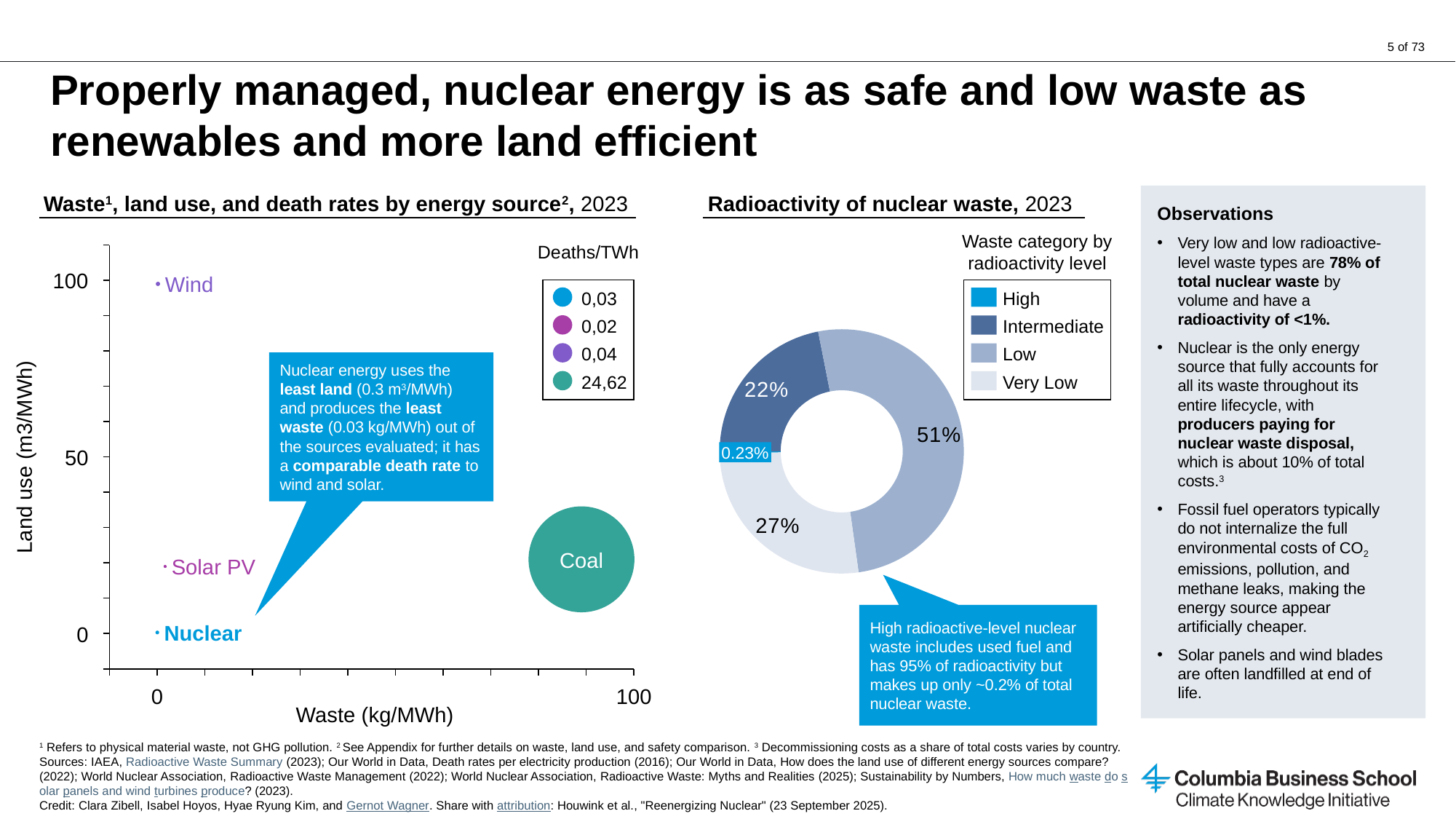
In the 'Waste, land use, and death rates by energy source, 2023' chart, is the waste value for Coal greater or less than 50 kg/MWh? greater In the 'Radioactivity of nuclear waste, 2023' chart, what share of nuclear waste is in the Low radioactivity category? 51% In the 'Radioactivity of nuclear waste, 2023' chart, what is the difference in percentage points between the Low and Very Low shares? 24 In the 'Radioactivity of nuclear waste, 2023' chart, which waste category has the largest share? Low In the 'Radioactivity of nuclear waste, 2023' chart, what share of nuclear waste is in the High radioactivity category? 0.23% How many waste categories does the legend of the 'Radioactivity of nuclear waste, 2023' chart list? 4 In the 'Waste, land use, and death rates by energy source, 2023' chart, what is the Deaths/TWh value for Coal? 24,62 In the 'Waste, land use, and death rates by energy source, 2023' chart, which energy source has the highest land use? Wind In the 'Waste, land use, and death rates by energy source, 2023' chart, is the land use value for Wind greater or less than 50 m3/MWh? greater In the 'Radioactivity of nuclear waste, 2023' chart, which waste category has the smallest share? High What kind of chart is the 'Radioactivity of nuclear waste, 2023' chart? Donut (pie) chart In the 'Radioactivity of nuclear waste, 2023' chart, which share is larger: Intermediate or Very Low? Very Low